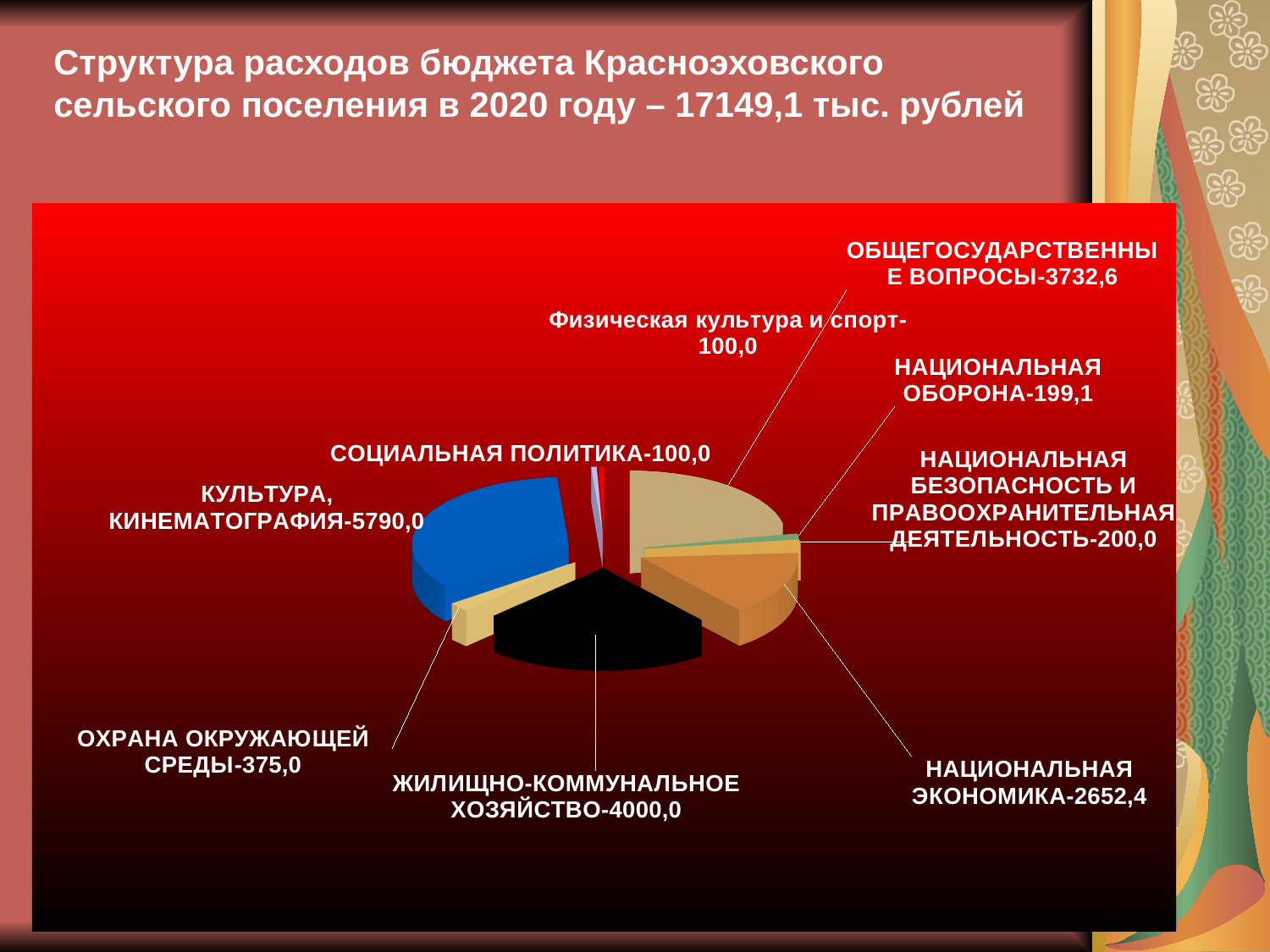
What is the difference between the values for ОБЩЕГОСУДАРСТВЕННЫЕ ВОПРОСЫ and НАЦИОНАЛЬНАЯ ЭКОНОМИКА? 1080,2 What is the difference between the values for КУЛЬТУРА, КИНЕМАТОГРАФИЯ and ЖИЛИЩНО-КОММУНАЛЬНОЕ ХОЗЯЙСТВО? 1790,0 Which year does the budget expenditure structure in the chart refer to? 2020 What is the value for ЖИЛИЩНО-КОММУНАЛЬНОЕ ХОЗЯЙСТВО? 4000,0 What is the value for НАЦИОНАЛЬНАЯ ЭКОНОМИКА? 2652,4 Which category has the largest value in the pie chart? КУЛЬТУРА, КИНЕМАТОГРАФИЯ What is the total budget expenditure shown in the slide title? 17149,1 тыс. рублей What is the value for ОХРАНА ОКРУЖАЮЩЕЙ СРЕДЫ? 375,0 What kind of chart is shown on the slide? Pie chart What is the value for НАЦИОНАЛЬНАЯ ОБОРОНА? 199,1 How many categories (slices) does the pie chart have? 9 Which is larger: ОБЩЕГОСУДАРСТВЕННЫЕ ВОПРОСЫ or НАЦИОНАЛЬНАЯ ЭКОНОМИКА? ОБЩЕГОСУДАРСТВЕННЫЕ ВОПРОСЫ